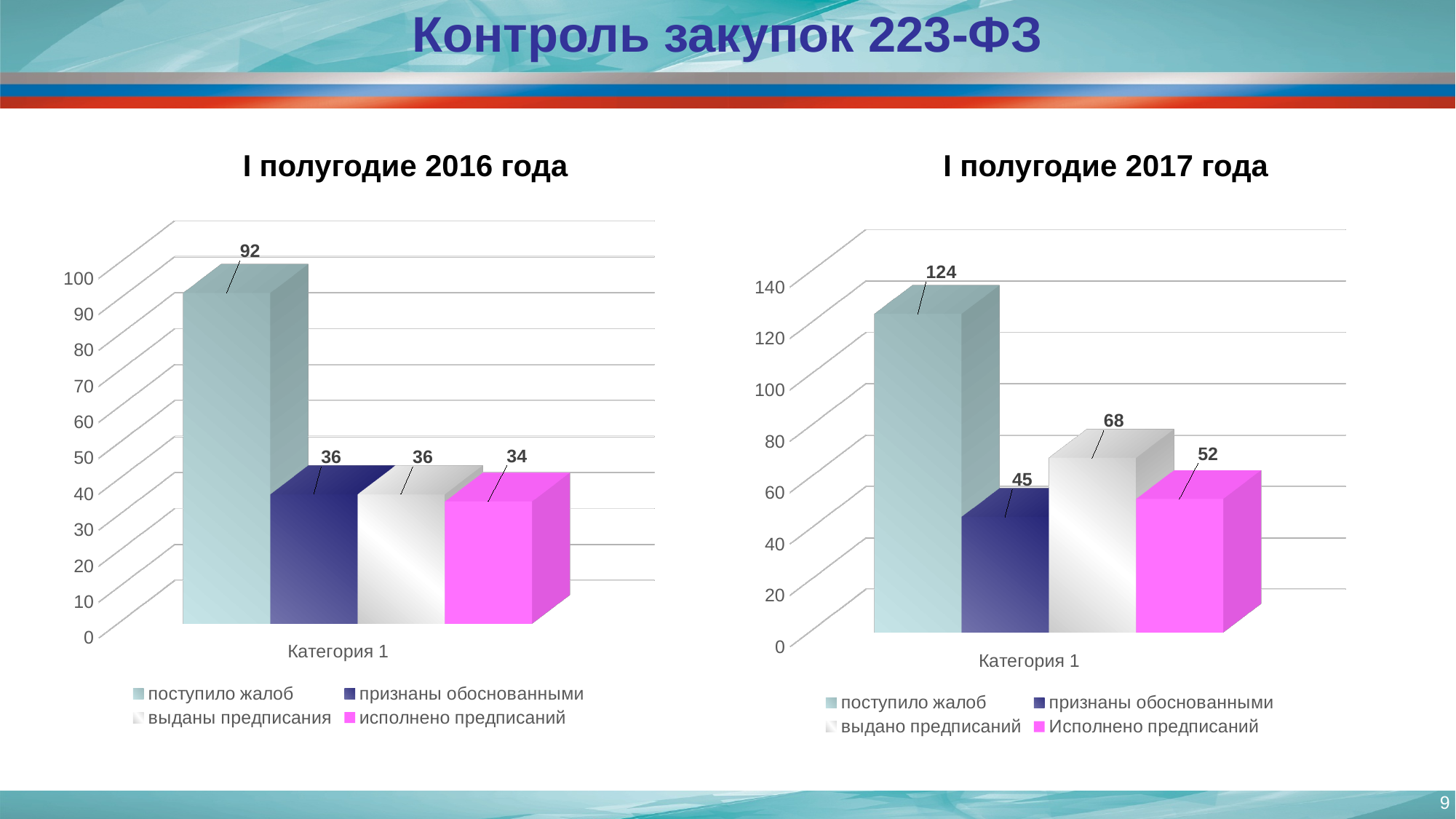
In the 'I полугодие 2017 года' chart, which is larger: 'выдано предписаний' or 'Исполнено предписаний'? выдано предписаний In the 'I полугодие 2016 года' chart, what colour is the bar for 'исполнено предписаний'? magenta (pink) In the 'I полугодие 2017 года' chart, what is the value for 'выдано предписаний'? 68 In the 'I полугодие 2016 года' chart, what is the difference between 'выданы предписания' and 'исполнено предписаний'? 2 In the 'I полугодие 2017 года' chart, which series has the lowest value? признаны обоснованными In the 'I полугодие 2016 года' chart, which series has the highest value? поступило жалоб In the 'I полугодие 2017 года' chart, what is the value for 'Исполнено предписаний'? 52 In the 'I полугодие 2017 года' chart, is the value for 'поступило жалоб' greater or less than 100? greater In the 'I полугодие 2017 года' chart, what is the difference between 'поступило жалоб' and 'признаны обоснованными'? 79 What kind of chart is the 'I полугодие 2017 года' chart? bar chart How many series does the legend of the 'I полугодие 2016 года' chart list? 4 In the 'I полугодие 2016 года' chart, what is the value for 'поступило жалоб'? 92